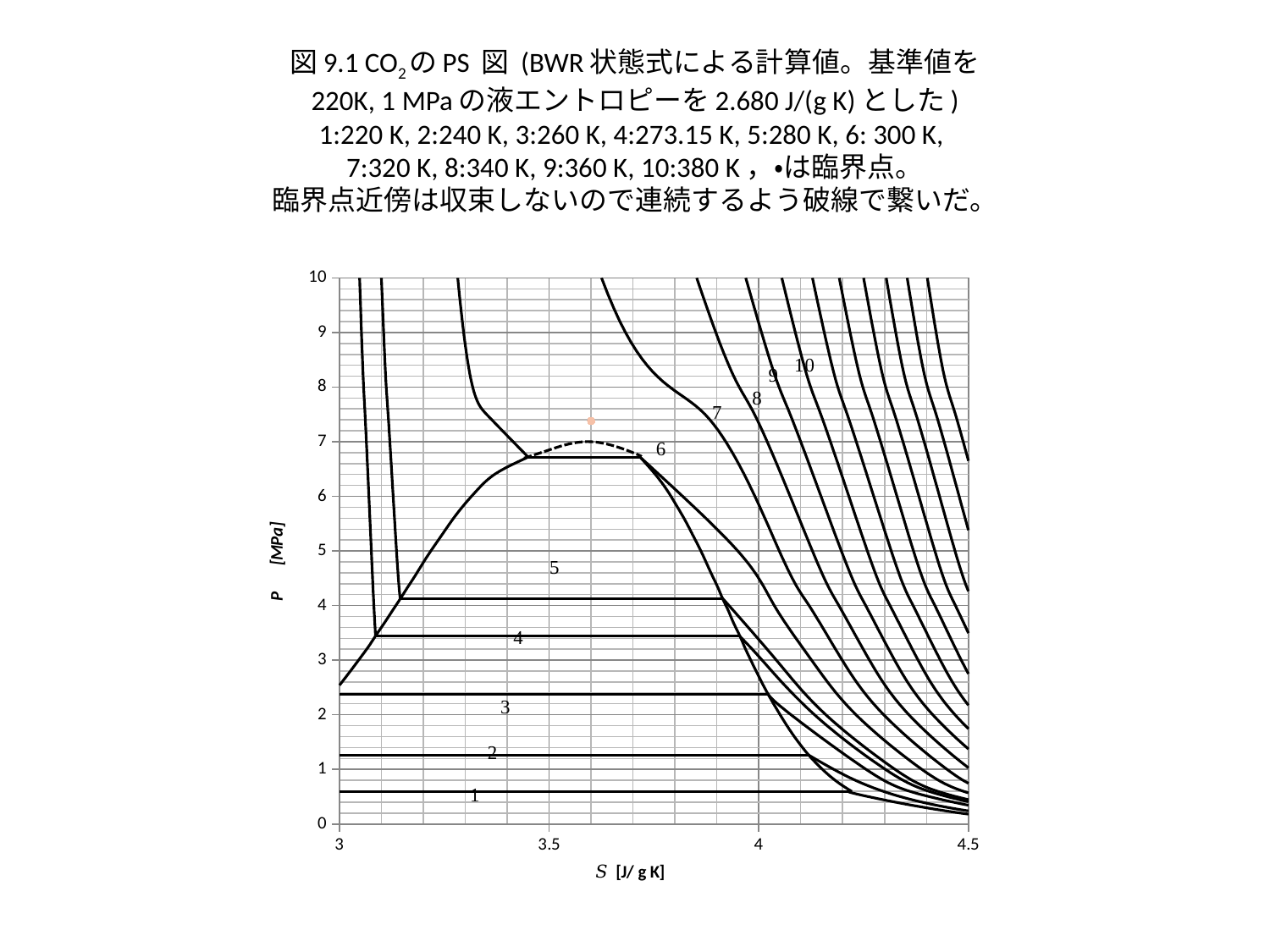
Is the pressure of the horizontal two-phase segment of isotherm 6 greater or less than 6 MPa? greater What quantity and unit are shown on the horizontal axis? S [J/g K] Is the pressure of the horizontal two-phase segment of isotherm 5 greater or less than 5 MPa? less What is the maximum value shown on the vertical P axis? 10 What kind of chart is shown on the slide? line chart Which isotherm has the higher two-phase (horizontal segment) pressure, isotherm 3 or isotherm 5? isotherm 5 What quantity and unit are shown on the vertical axis? P [MPa] Is the pressure of the horizontal two-phase segment of isotherm 3 greater or less than 2 MPa? greater How many numbered isotherms are labelled on the chart? 10 What is the maximum value shown on the horizontal S axis? 4.5